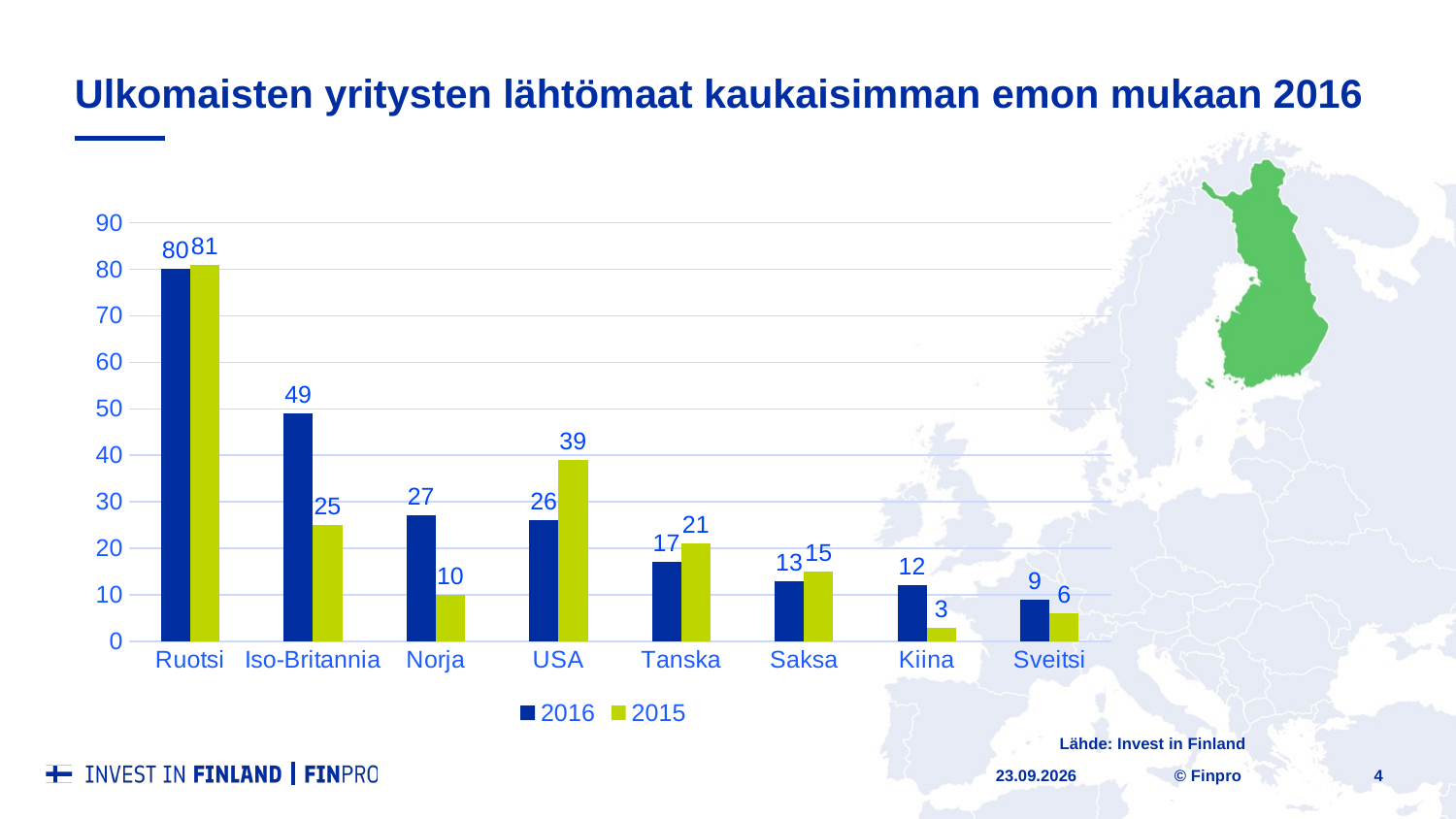
What kind of chart is shown on the slide? bar chart How many countries are shown on the x axis? 8 Which country has the lowest 2015 value? Kiina What is the 2015 value for USA? 39 What is the title of the chart? Ulkomaisten yritysten lähtömaat kaukaisimman emon mukaan 2016 Which country has the highest 2016 value? Ruotsi What is the 2016 value for Iso-Britannia? 49 How many series does the legend list? 2 What is the 2015 value for Kiina? 3 What is the difference between the 2016 and 2015 values for Iso-Britannia? 24 Is the 2016 value for Norja greater or less than 20? greater Which is larger for USA, the 2016 value or the 2015 value? 2015